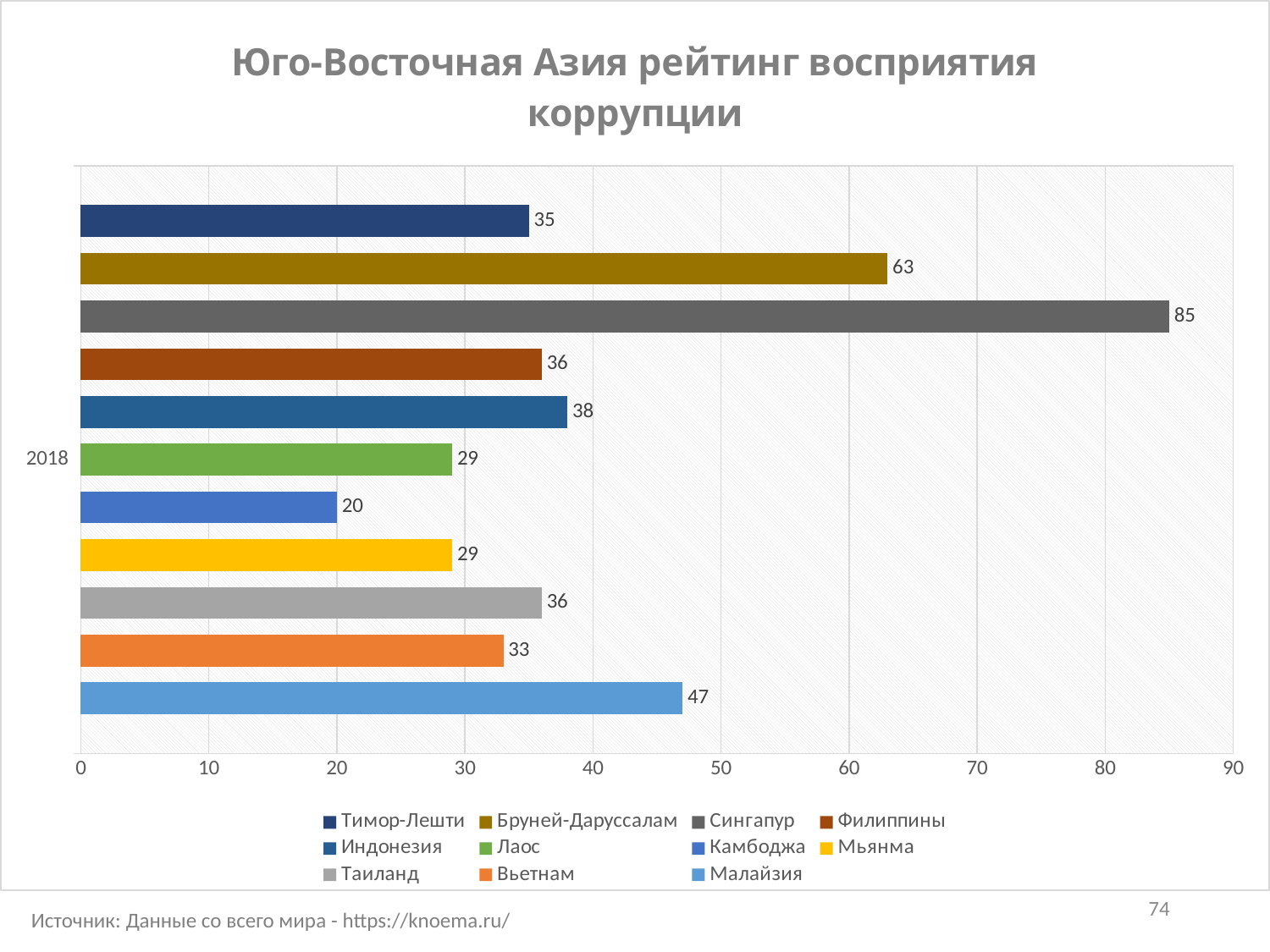
Is the value for Бруней-Даруссалам greater or less than 60? greater What is the value for Малайзия in 2018? 47 What is the value for Сингапур in 2018? 85 What is the difference between the values for Сингапур and Бруней-Даруссалам? 22 What year is shown on the category axis of the chart? 2018 What kind of chart is shown on the slide? bar chart What is the difference between the values for Малайзия and Вьетнам? 14 Which country has the lowest value on the chart? Камбоджа Which country has the highest value on the chart? Сингапур How many series does the legend list? 11 What is the value for Камбоджа in 2018? 20 Which is larger, the value for Индонезия or the value for Филиппины? Индонезия